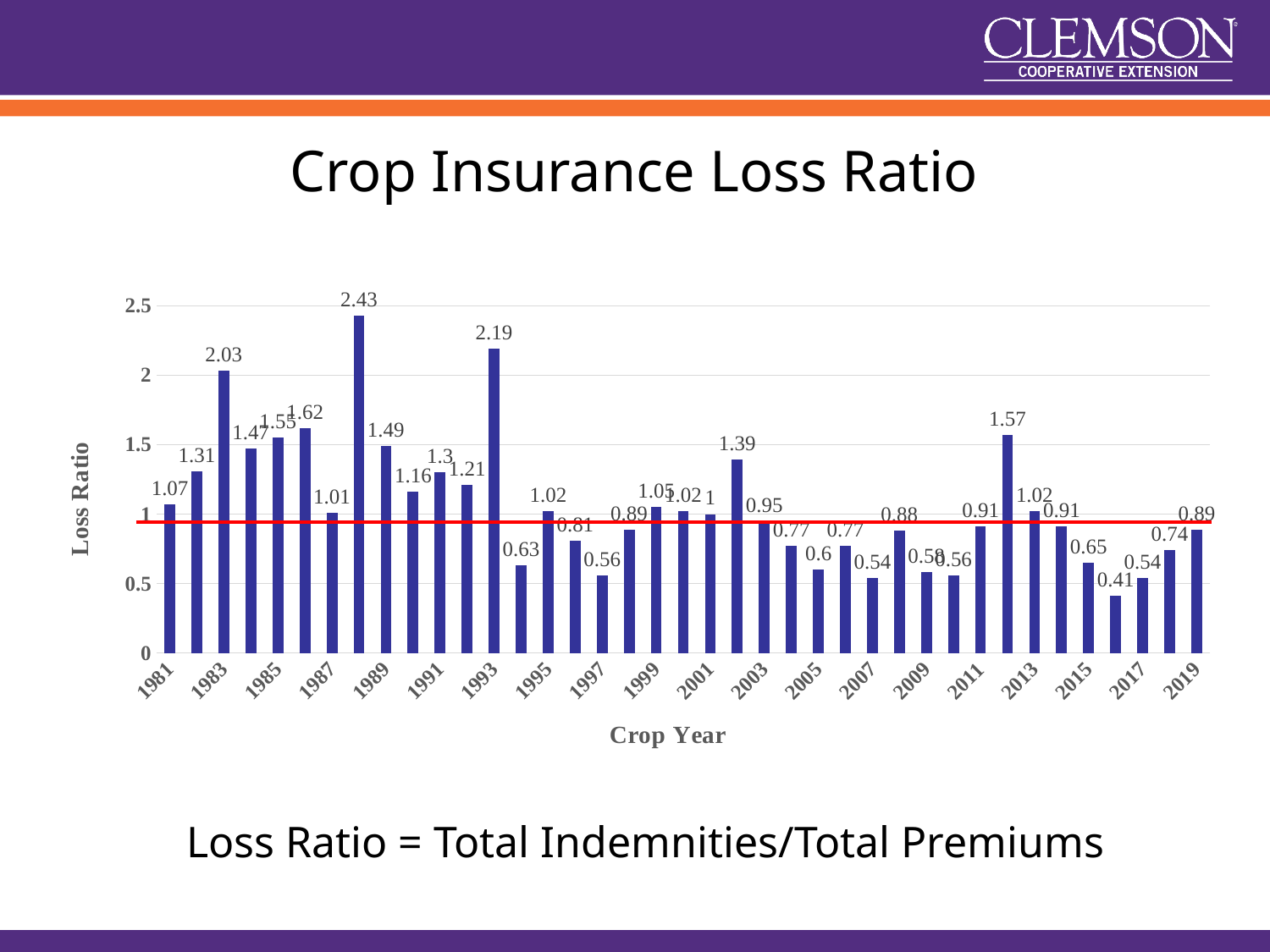
What is the title of the chart's vertical axis? Loss Ratio What is the loss ratio for crop year 2003? 0.95 Is the loss ratio for crop year 1997 greater or less than 1? less What type of chart is shown on the slide? bar chart What is the highest loss ratio value shown in the chart? 2.43 How many crop years (bars) are plotted in the chart? 39 What is the loss ratio for crop year 1993? 2.19 Which crop year has the larger loss ratio, 1989 or 2009? 1989 What is the lowest loss ratio value shown in the chart? 0.41 What is the loss ratio for crop year 2019? 0.89 What is the difference between the loss ratio in 1993 and the loss ratio in 1983? 0.16 What is the loss ratio for crop year 1983? 2.03